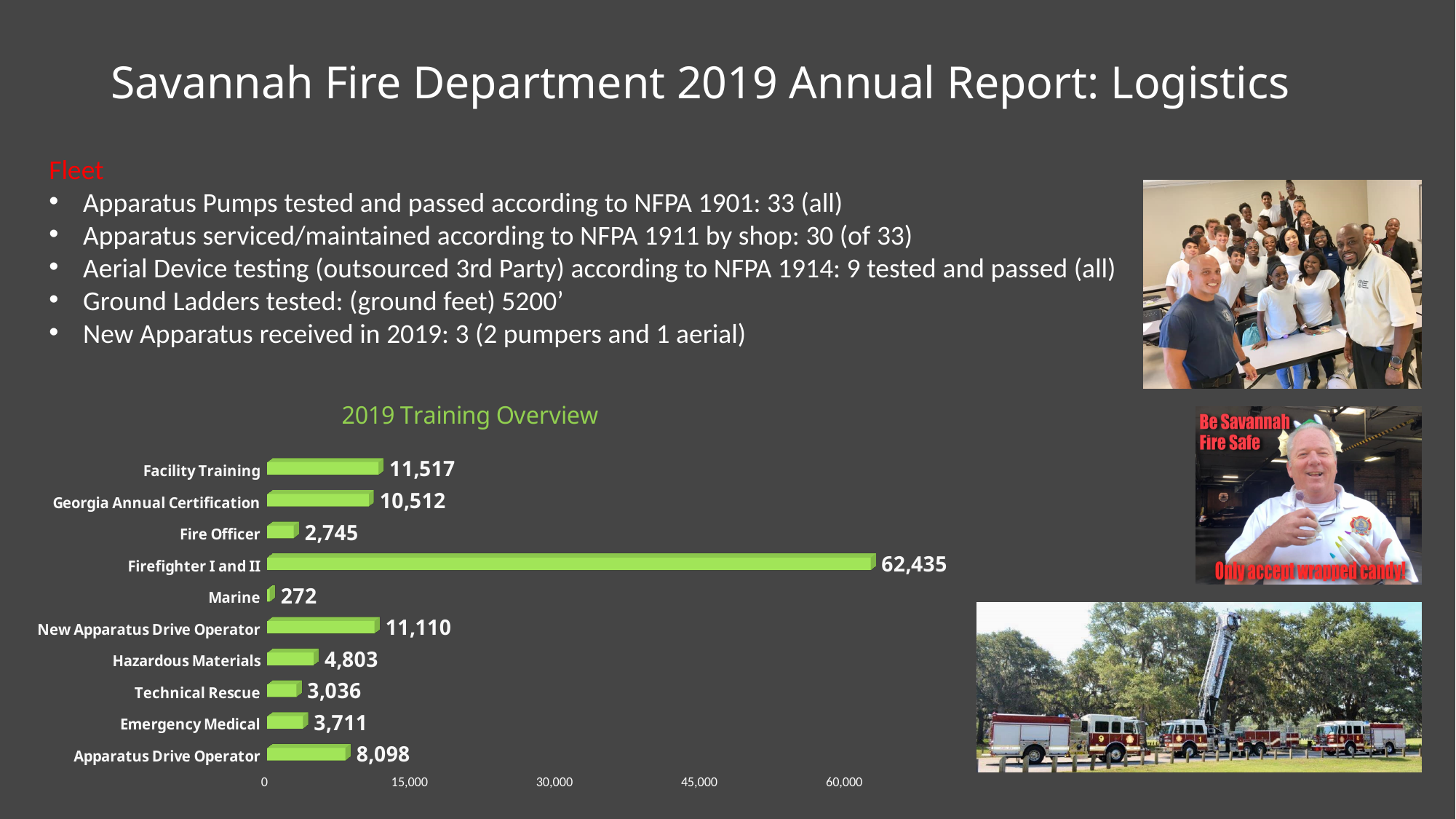
What is the difference between Hazardous Materials and Emergency Medical in the 2019 Training Overview chart? 1,092 What kind of chart is the 2019 Training Overview? Bar chart What is the title of the chart on the slide? 2019 Training Overview What is the value for Apparatus Drive Operator in the 2019 Training Overview chart? 8,098 What is the difference between Facility Training and Georgia Annual Certification in the 2019 Training Overview chart? 1,005 Which is larger in the 2019 Training Overview chart, Technical Rescue or Emergency Medical? Emergency Medical Is the value for Firefighter I and II greater or less than 60,000 in the 2019 Training Overview chart? greater Which category has the highest value in the 2019 Training Overview chart? Firefighter I and II What is the value for Hazardous Materials in the 2019 Training Overview chart? 4,803 How many categories are shown in the 2019 Training Overview chart? 10 Which category has the lowest value in the 2019 Training Overview chart? Marine What is the value for Firefighter I and II in the 2019 Training Overview chart? 62,435